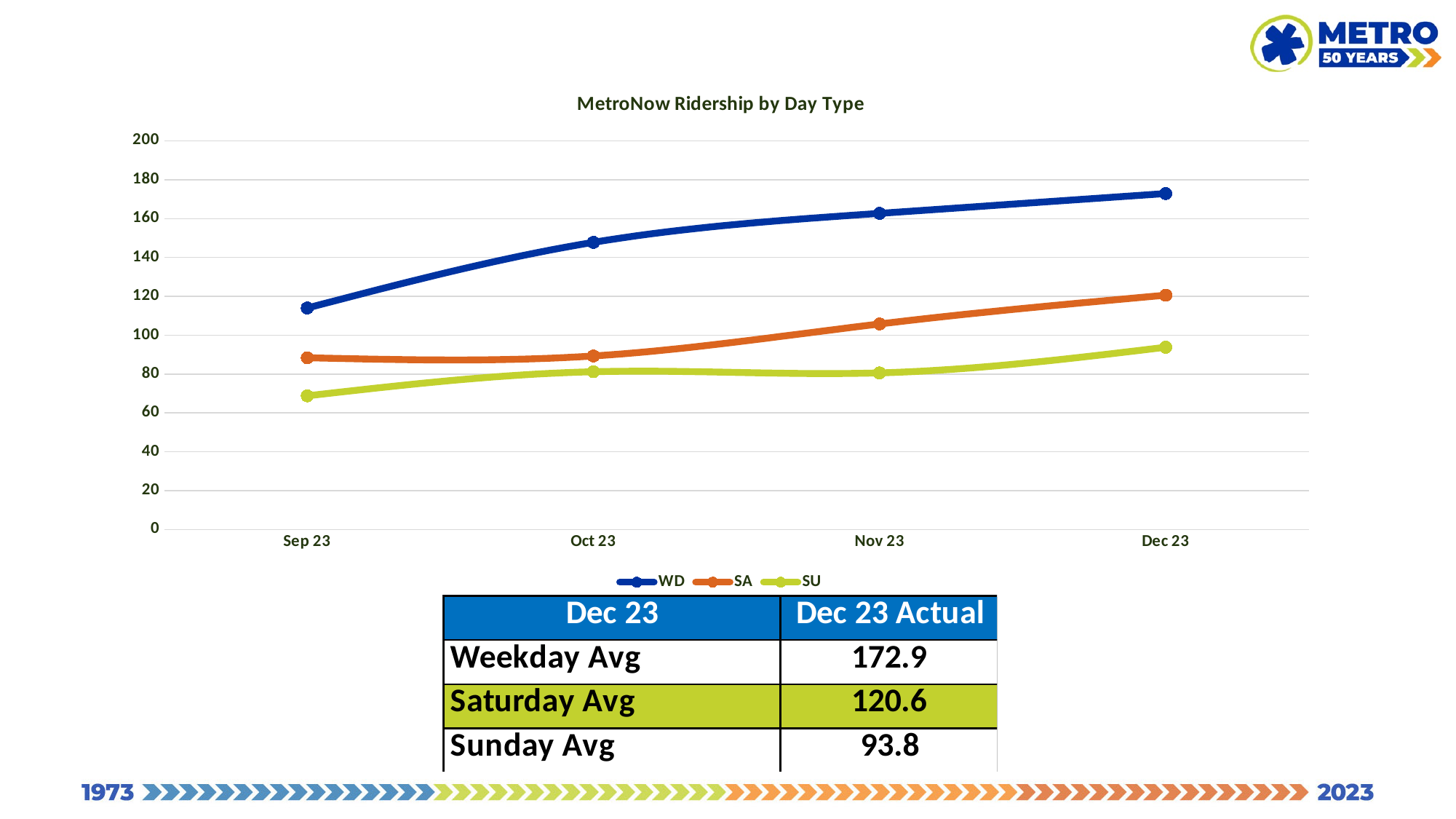
What is the difference between the Dec 23 Weekday Avg and the Dec 23 Saturday Avg? 52.3 Does the WD series rise or fall from Sep 23 to Dec 23? rise How many series does the chart legend list? 3 Which series has the highest value in Dec 23? WD How many months are plotted along the x axis? 4 What type of chart is shown on the slide? line chart Is the value for WD in Sep 23 greater or less than 100? greater What is the Dec 23 actual value for the Saturday Avg? 120.6 Which is larger in Sep 23, SA or SU? SA What is the Dec 23 actual value for the Weekday Avg? 172.9 What is the title of the chart? MetroNow Ridership by Day Type What is the Dec 23 actual value for the Sunday Avg? 93.8